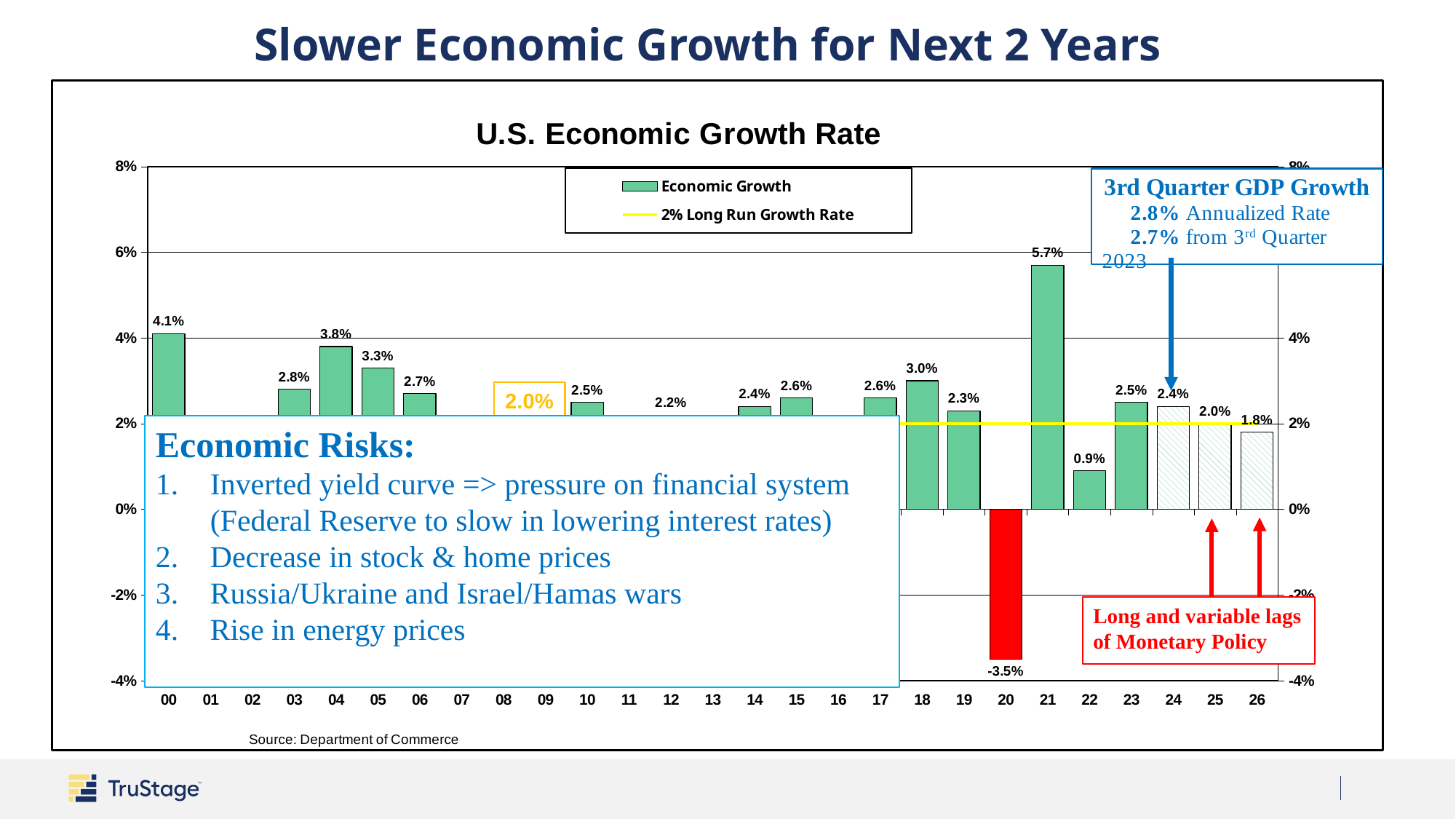
What is the difference between the growth rates for 21 and 22? 4.8 percentage points What is the economic growth rate shown for 21? 5.7% Which year has the lowest economic growth rate on the chart? 20 Which year has the highest economic growth rate on the chart? 21 Do the growth rates rise or fall from 24 to 26? Fall How many years are labeled on the x axis of the chart? 27 How many series does the legend list? 2 What is the difference between the growth rates for 24 and 26? 0.6 percentage points What kind of chart is used to show the U.S. Economic Growth Rate? Combination bar and line chart What is the economic growth rate shown for 20? -3.5% Which year has the higher growth rate, 04 or 05? 04 What is the economic growth rate shown for 26? 1.8%